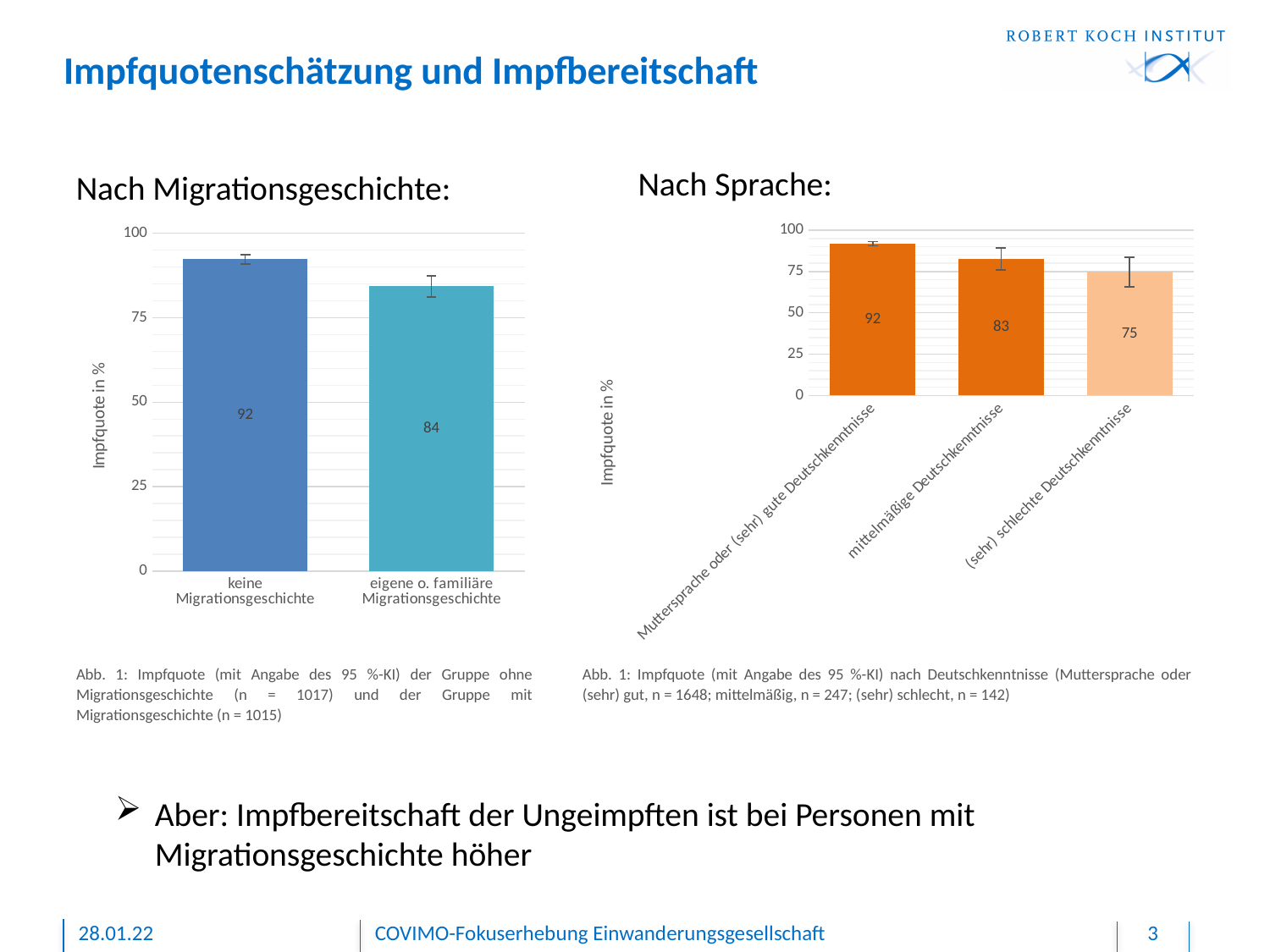
In the 'Nach Sprache' chart, what is the difference between 'Muttersprache oder (sehr) gute Deutschkenntnisse' and '(sehr) schlechte Deutschkenntnisse'? 17 In the 'Nach Sprache' chart, which category has the lowest Impfquote? (sehr) schlechte Deutschkenntnisse In the 'Nach Migrationsgeschichte' chart, what is the Impfquote for 'keine Migrationsgeschichte'? 92 In the 'Nach Migrationsgeschichte' chart, what is the Impfquote for 'eigene o. familiäre Migrationsgeschichte'? 84 What kind of chart is the 'Nach Sprache' chart? bar chart In the 'Nach Migrationsgeschichte' chart, which group has the higher Impfquote? keine Migrationsgeschichte In the 'Nach Sprache' chart, do the values rise or fall from left to right? fall How many categories are shown in the 'Nach Migrationsgeschichte' chart? 2 In the 'Nach Sprache' chart, which category has the highest Impfquote? Muttersprache oder (sehr) gute Deutschkenntnisse In the 'Nach Sprache' chart, what is the Impfquote for '(sehr) schlechte Deutschkenntnisse'? 75 In the 'Nach Sprache' chart, what is the Impfquote for 'mittelmäßige Deutschkenntnisse'? 83 In the 'Nach Migrationsgeschichte' chart, what is the difference between the two bars? 8